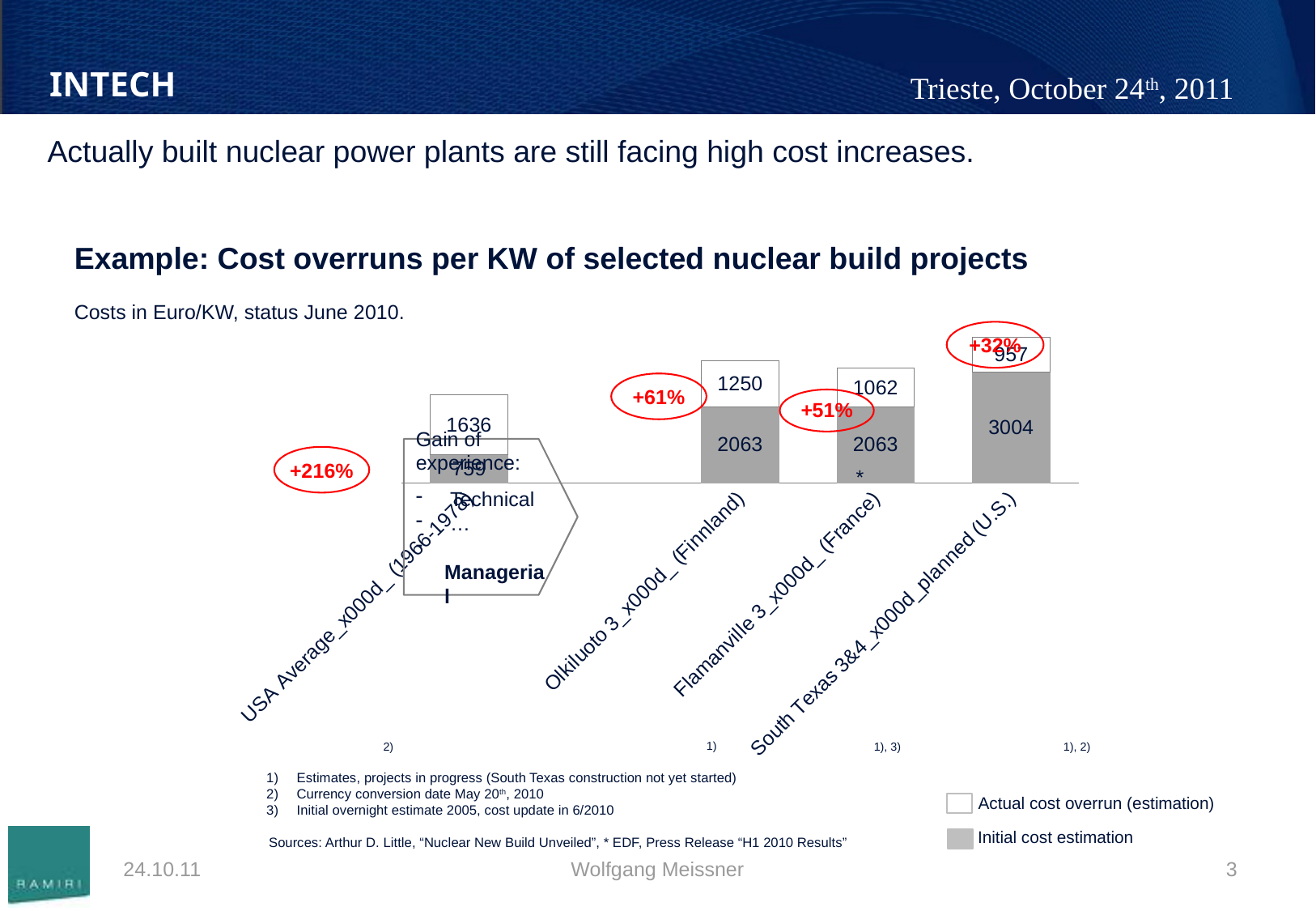
How many series does the legend list? 2 What percentage cost overrun is shown for Olkiluoto 3 (Finnland)? +61% What is the initial cost estimation for South Texas 3&4 planned (U.S.)? 3004 What percentage cost overrun is shown for the USA Average? +216% Which project has the highest initial cost estimation? South Texas 3&4 planned (U.S.) What is the difference between the actual cost overrun of Olkiluoto 3 and that of Flamanville 3? 188 Which has the larger actual cost overrun, Olkiluoto 3 or South Texas 3&4? Olkiluoto 3 What is the initial cost estimation for Olkiluoto 3 (Finnland)? 2063 What is the total cost (initial estimation plus overrun) for Olkiluoto 3 (Finnland)? 3313 What is the actual cost overrun (estimation) for Flamanville 3 (France)? 1062 What kind of chart is shown on the slide? Stacked bar chart What is the total cost (initial estimation plus overrun) for South Texas 3&4 planned (U.S.)? 3961